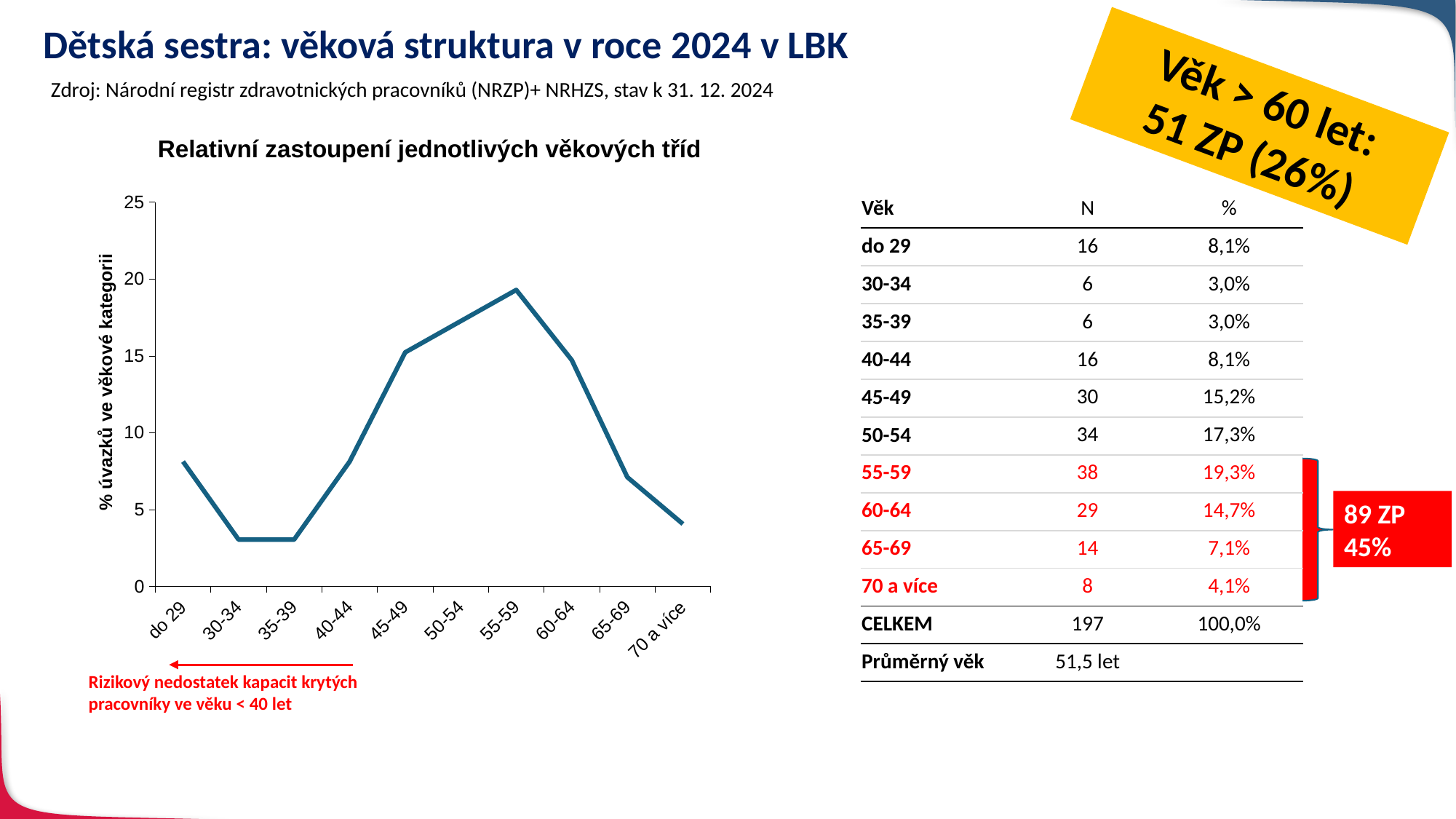
What is the label of the y axis of the chart? % úvazků ve věkové kategorii What is the title of the chart? Relativní zastoupení jednotlivých věkových tříd Which age category has the highest value in the chart? 55-59 Is the value for 55-59 in the chart greater or less than 15? greater Is the value for 70 a více in the chart greater or less than 5? less What kind of chart is shown on the slide? line chart Is the value for 30-34 in the chart greater or less than 5? less Which is larger in the chart, the value for 50-54 or the value for 65-69? 50-54 Do the values in the chart rise or fall from 55-59 to 70 a více? fall How many age categories are plotted on the x axis of the chart? 10 According to the table on the slide, what percentage corresponds to the 55-59 age category? 19,3%